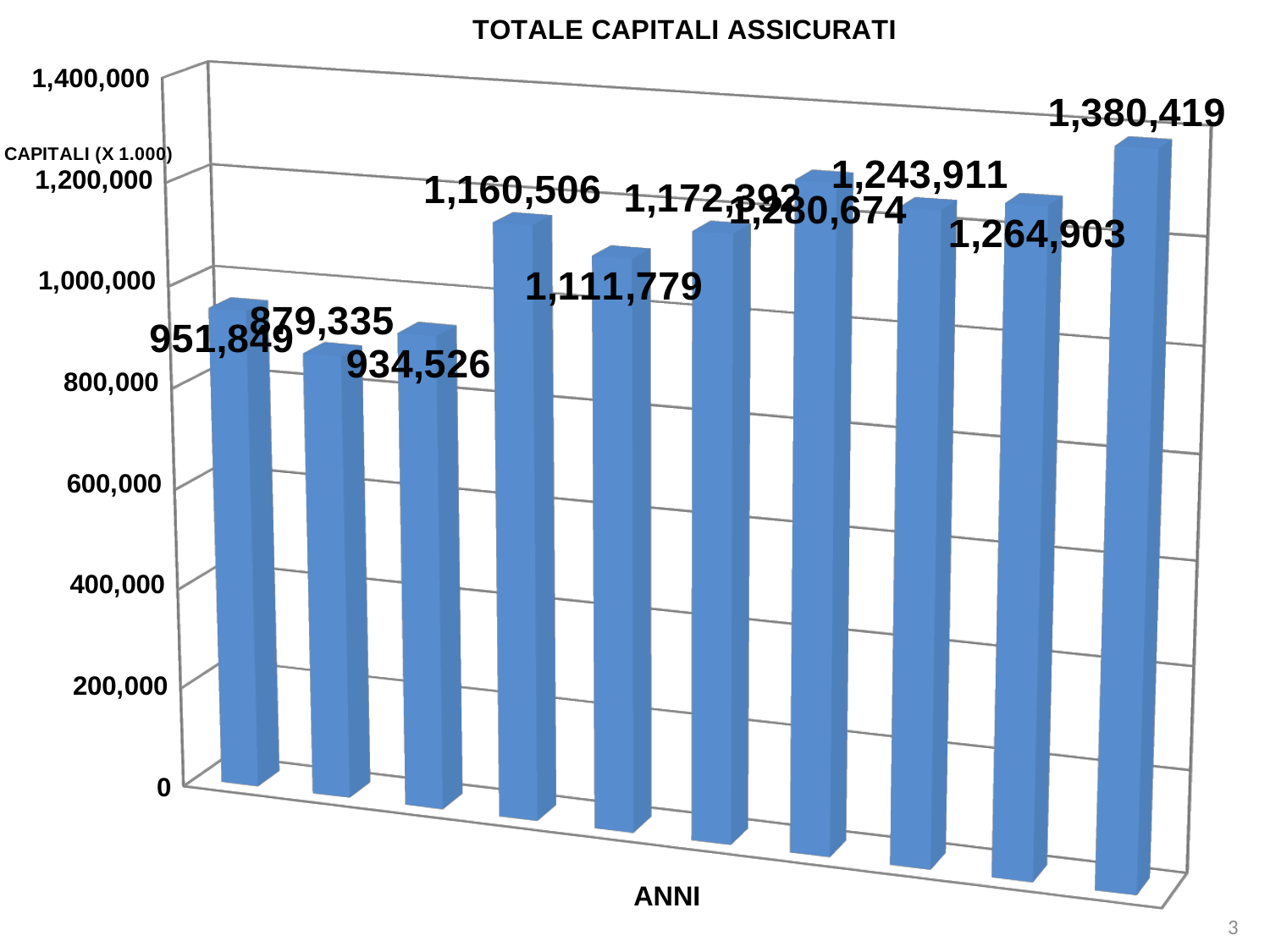
What is the value of the first (leftmost) bar? 951,849 What is the value of the last (rightmost) bar? 1,380,419 Is the value of the third bar from the left greater or less than 1,000,000? less What kind of chart is shown on the slide? bar chart What is the value of the second bar from the left? 879,335 How many bars are plotted in the chart? 10 What is the highest value shown in the chart? 1,380,419 Which is larger, the value of the fourth bar (1,160,506) or the fifth bar (1,111,779)? 1,160,506 What is the lowest value shown in the chart? 879,335 What is the title of the chart? TOTALE CAPITALI ASSICURATI What is the label of the horizontal axis? ANNI What is the difference between the rightmost bar (1,380,419) and the leftmost bar (951,849)? 428,570